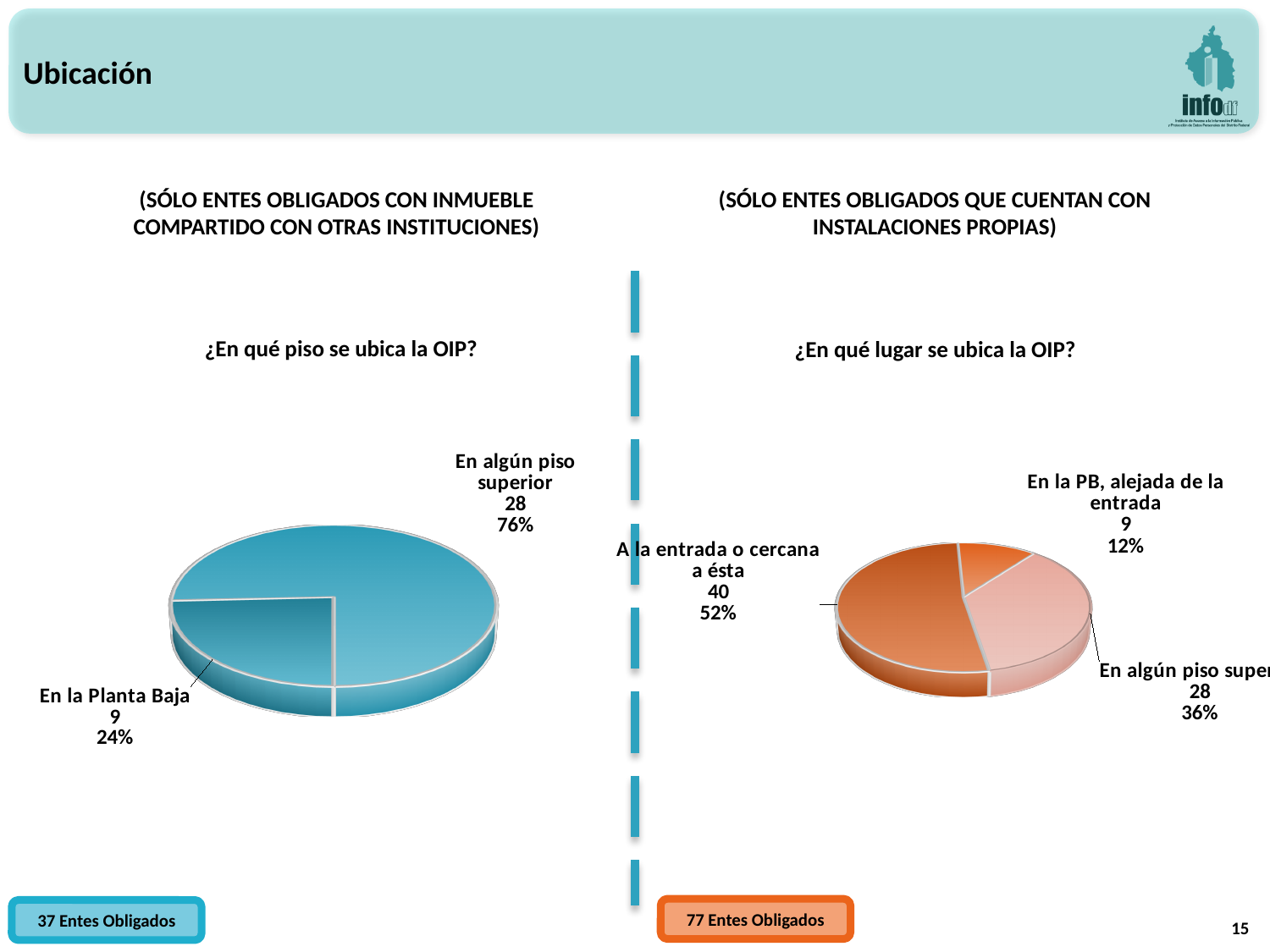
In the left chart '¿En qué piso se ubica la OIP?', how many entes obligados are in 'En algún piso superior'? 28 In the right chart '¿En qué lugar se ubica la OIP?', what percentage does 'En la PB, alejada de la entrada' represent? 12% In the right chart '¿En qué lugar se ubica la OIP?', what is the difference between the counts for 'A la entrada o cercana a ésta' and 'En la PB, alejada de la entrada'? 31 What type of chart is used on the left side of the slide? Pie chart In the right chart '¿En qué lugar se ubica la OIP?', how many entes obligados are in 'A la entrada o cercana a ésta'? 40 In the left chart '¿En qué piso se ubica la OIP?', what is the difference between the counts for 'En algún piso superior' and 'En la Planta Baja'? 19 In the left chart '¿En qué piso se ubica la OIP?', which category has the largest slice? En algún piso superior In the right chart '¿En qué lugar se ubica la OIP?', which category has the smallest slice? En la PB, alejada de la entrada How many entes obligados does the box below the right chart state? 77 Entes Obligados In the right chart '¿En qué lugar se ubica la OIP?', how many categories are shown? 3 In the left chart '¿En qué piso se ubica la OIP?', what percentage does 'En la Planta Baja' represent? 24% In the right chart '¿En qué lugar se ubica la OIP?', which is larger: 'A la entrada o cercana a ésta' or 'En la PB, alejada de la entrada'? A la entrada o cercana a ésta